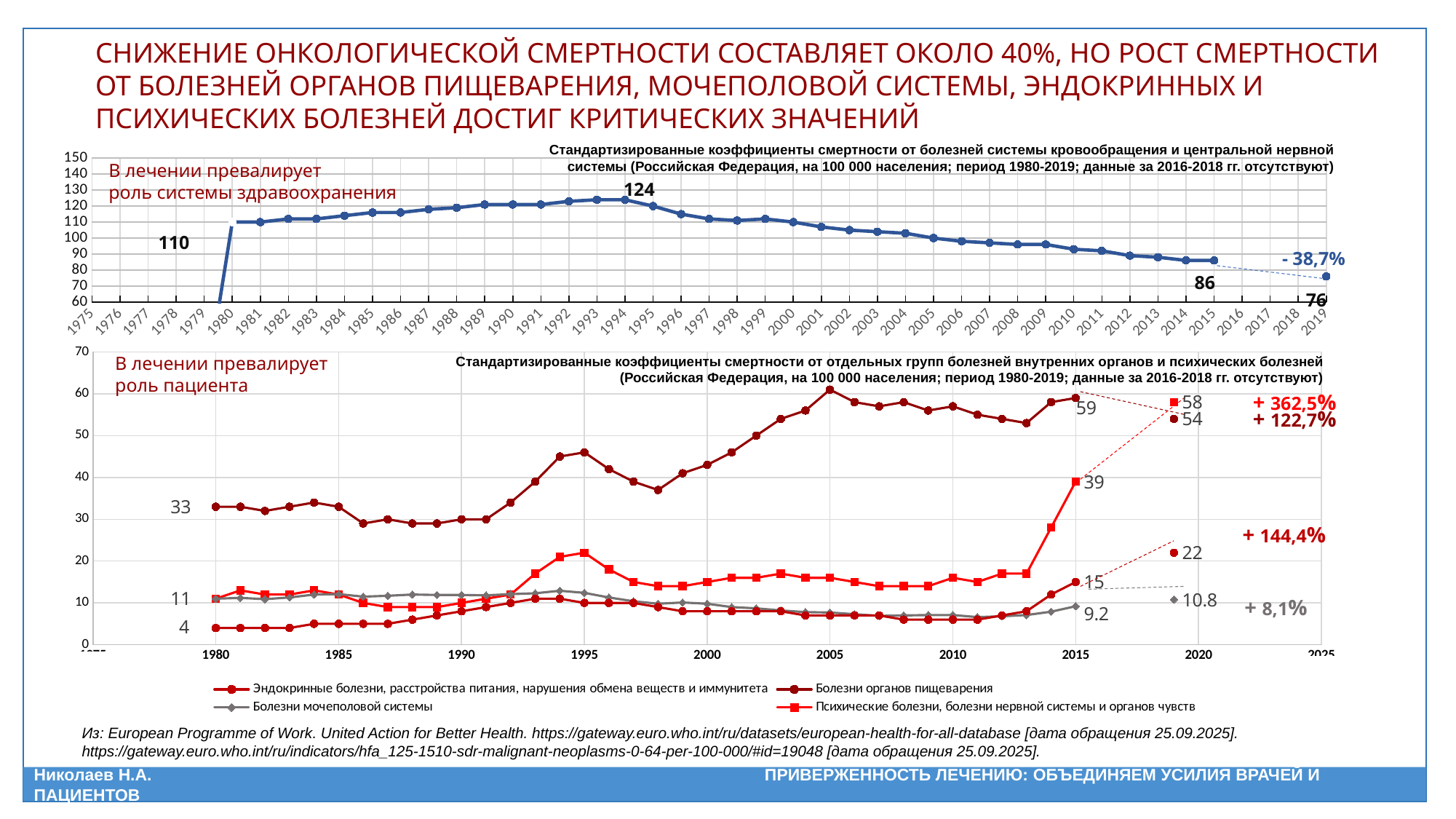
In the bottom chart, what is the value for Психические болезни, болезни нервной системы и органов чувств in 2019? 58 In the top chart, what is the difference between the 1994 value and the 2015 value? 38 In the top chart, what is the value for 1994? 124 In the top chart, what is the value for 2015? 86 How many series does the legend of the bottom chart list? 4 What kind of chart is the top chart on the slide? line chart In the bottom chart, what is the value for Болезни мочеполовой системы in 2019? 10.8 In the bottom chart, what is the value for Болезни органов пищеварения in 2015? 59 In the top chart, what percentage change is printed at the right end of the line? - 38,7% In the bottom chart, does the line for Болезни органов пищеварения rise or fall from 1980 to 2015? rise In the bottom chart, which is larger in 2019: Болезни органов пищеварения or Психические болезни, болезни нервной системы и органов чувств? Психические болезни, болезни нервной системы и органов чувств In the top chart, what is the value for 2019? 76